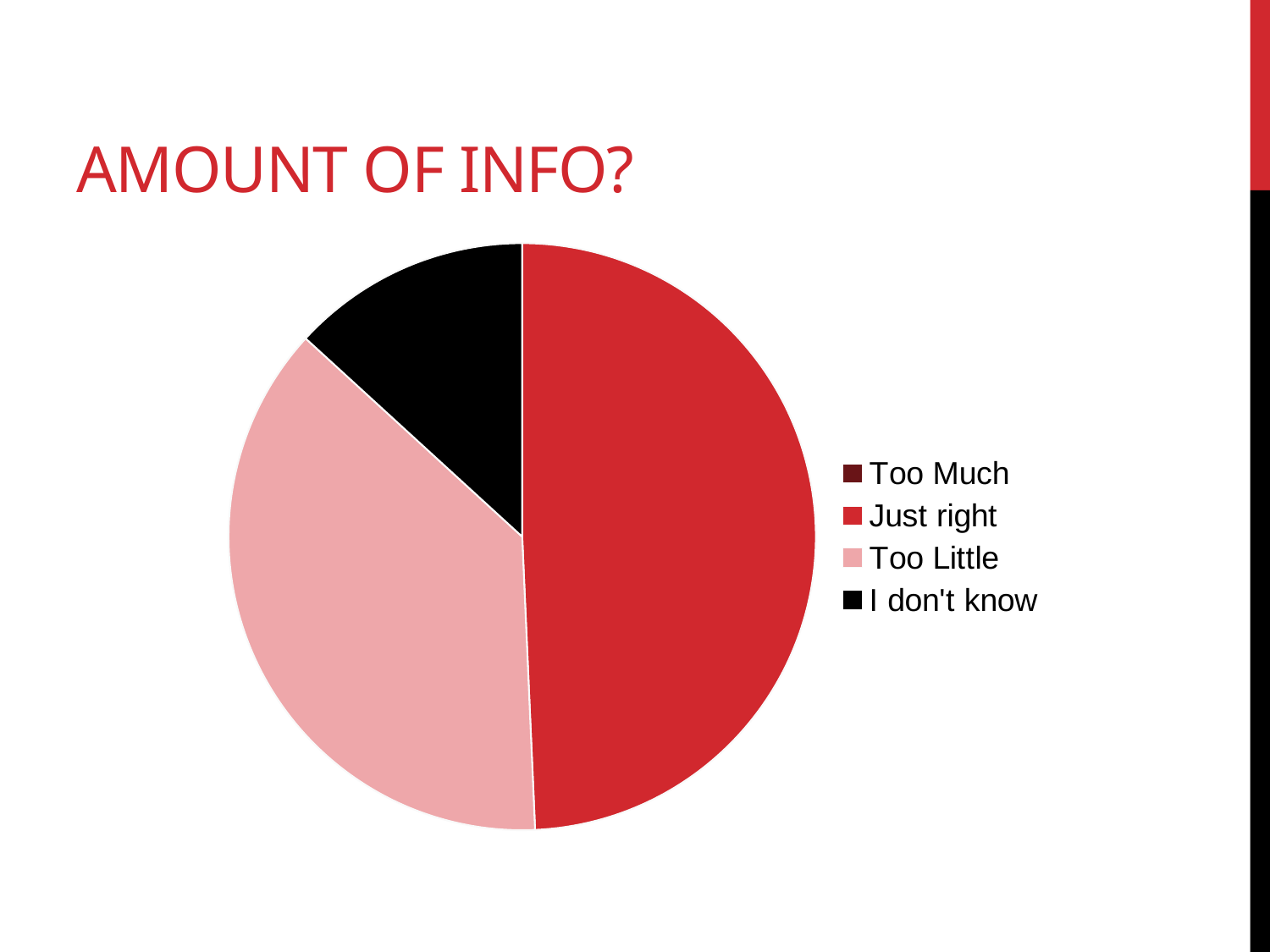
Which is smaller, the slice for I don't know or the slice for Just right? I don't know How many entries does the legend list? 4 Which is larger, the slice for Just right or the slice for Too Little? Just right Which is larger, the slice for Too Little or the slice for I don't know? Too Little What is the title of the slide's chart? AMOUNT OF INFO? Which category has the largest slice of the pie? Just right What kind of chart is shown on the slide? pie chart What colour is the slice for I don't know? black